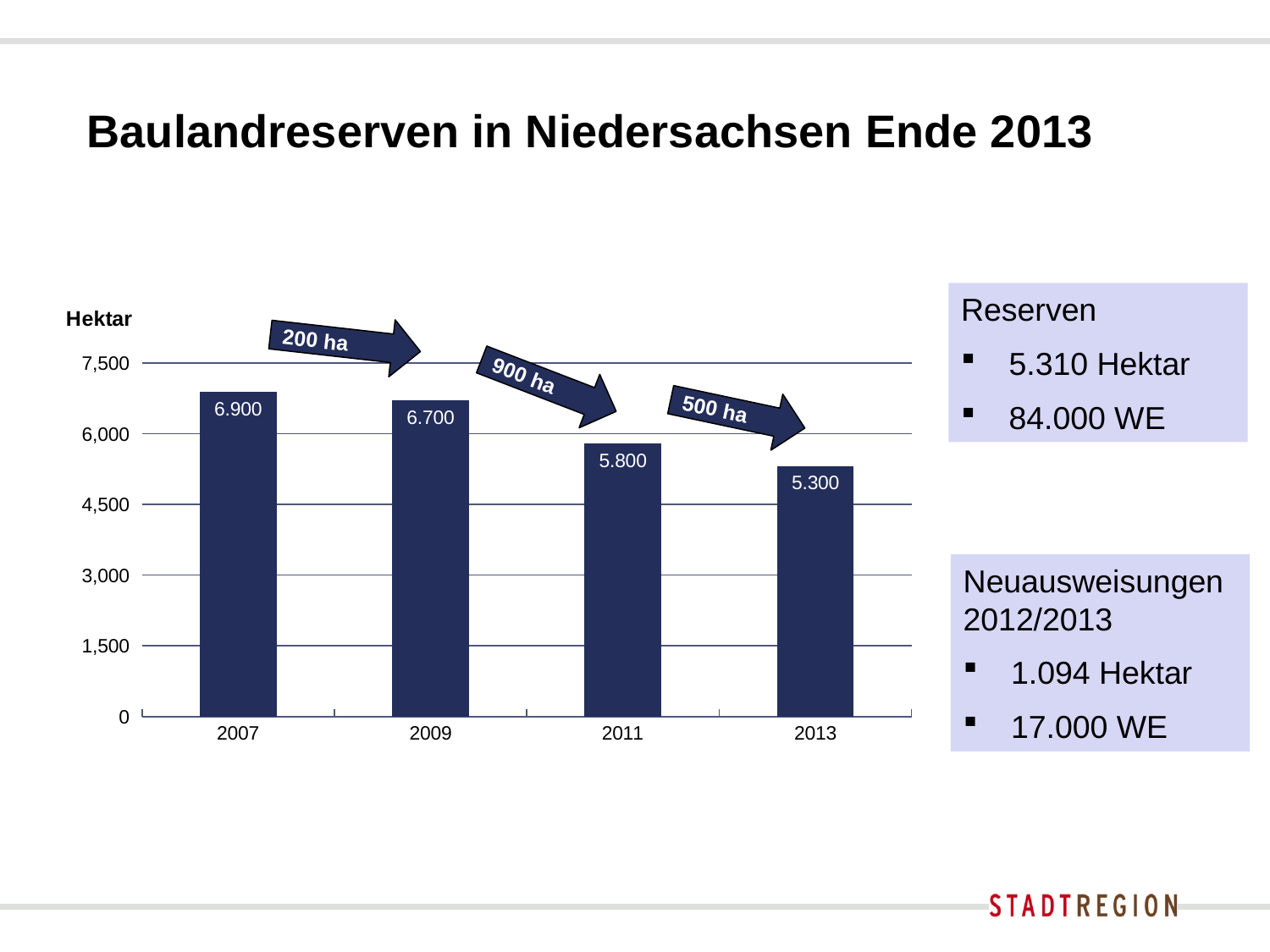
What is the value for 2007? 6.900 Which year has the highest value? 2007 What is the value for 2013? 5.300 What is the value for 2009? 6.700 Do the values rise or fall from 2007 to 2013? fall What kind of chart is shown? bar chart Which year has the lowest value? 2013 How many years are shown on the x axis? 4 What is the value for 2011? 5.800 Which is larger, the value for 2009 or the value for 2013? 2009 What is the difference between the values for 2009 and 2011? 900 What is the difference between the values for 2007 and 2013? 1.600